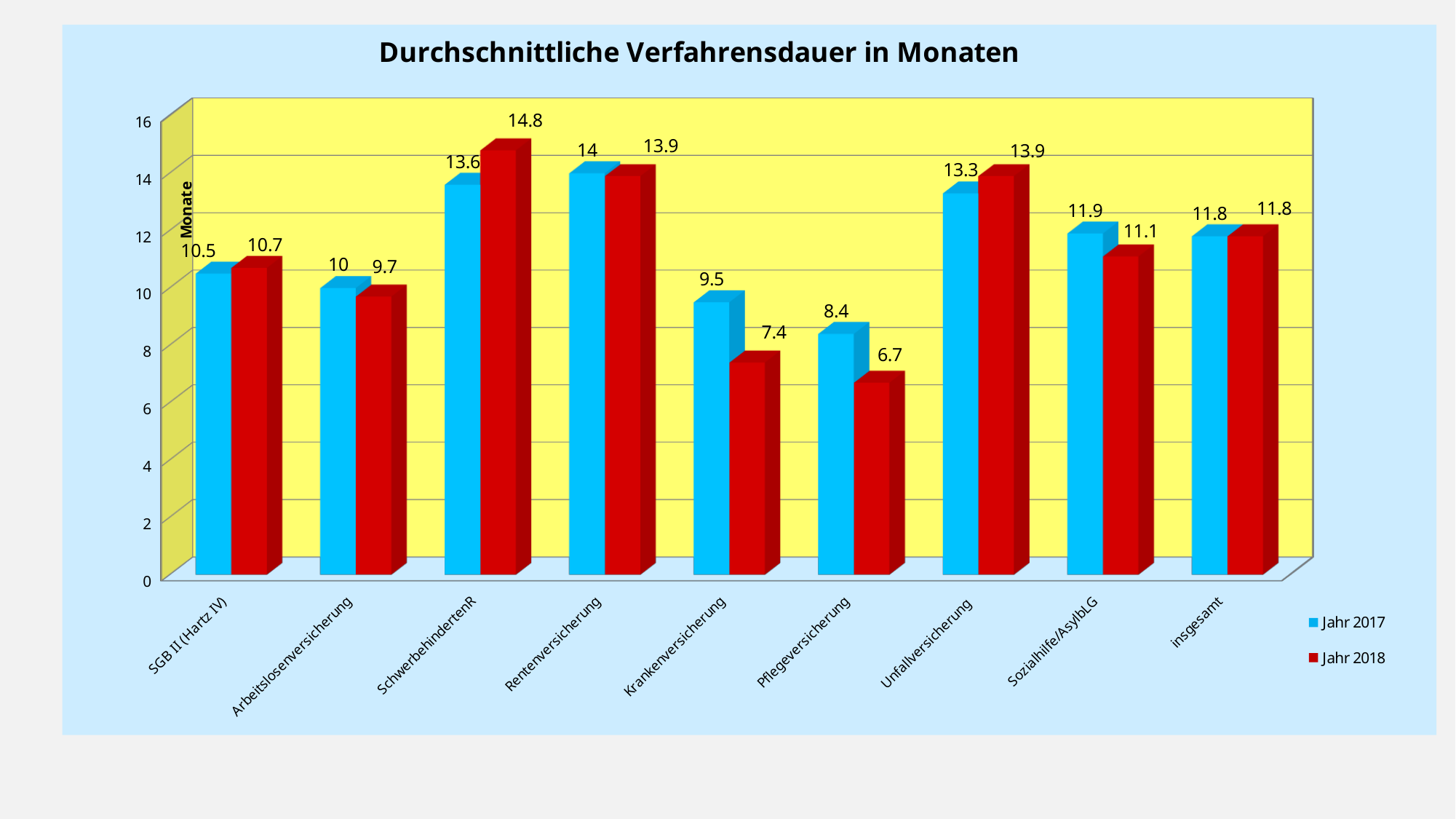
What is the difference between the Jahr 2018 and Jahr 2017 values for Krankenversicherung? 2.1 What is the value for Jahr 2018 for SchwerbehindertenR? 14.8 How many series does the legend list? 2 How many categories are shown on the x axis? 9 What is the value for Jahr 2017 for insgesamt? 11.8 What is the value for Jahr 2017 for Pflegeversicherung? 8.4 What kind of chart is shown on the slide? Bar chart Which is larger for Unfallversicherung, the Jahr 2017 value or the Jahr 2018 value? Jahr 2018 Which category has the highest value for Jahr 2017? Rentenversicherung What is the value for Jahr 2018 for Krankenversicherung? 7.4 What is the title of the chart? Durchschnittliche Verfahrensdauer in Monaten Which category has the lowest value for Jahr 2018? Pflegeversicherung